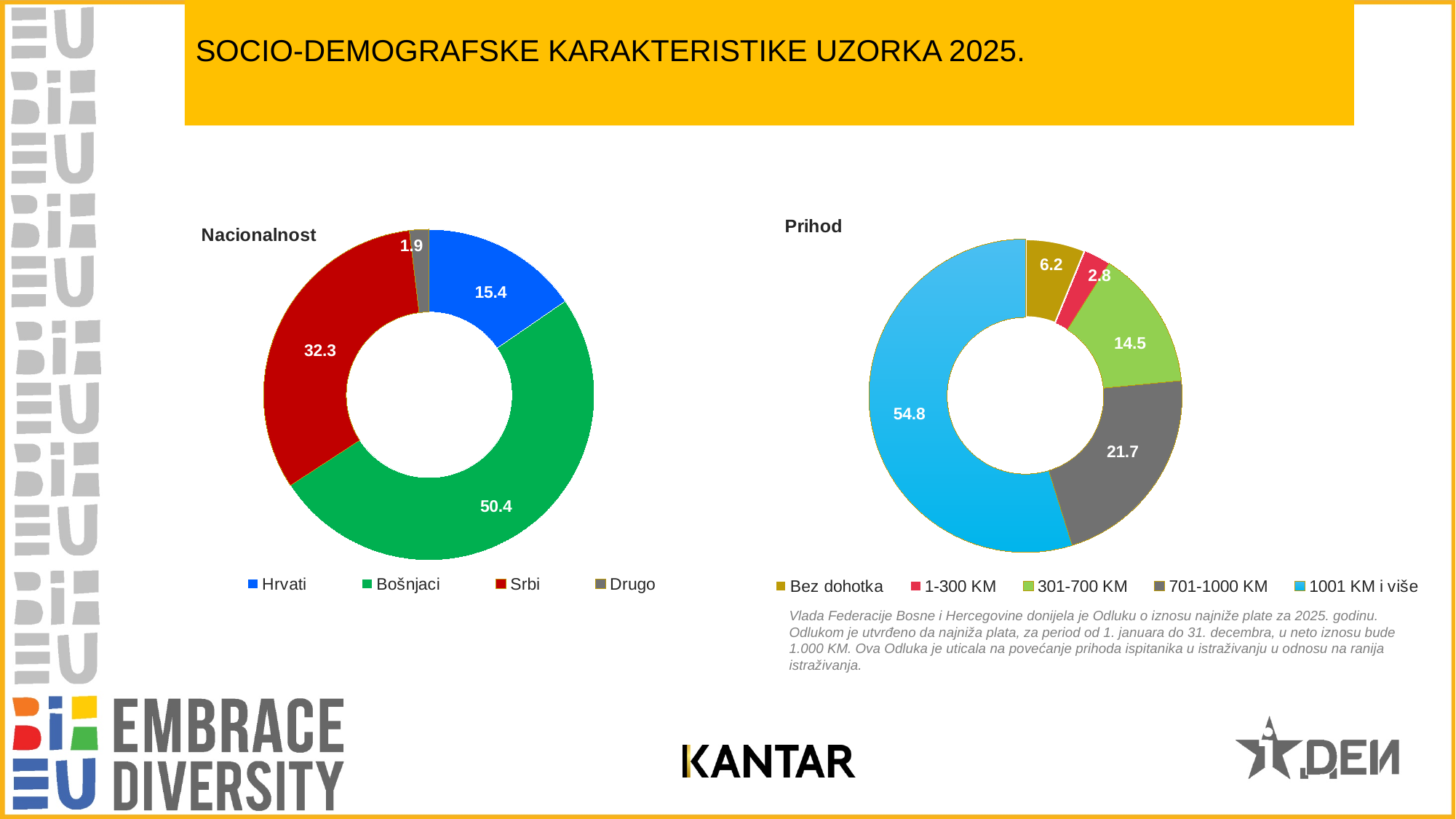
In the Prihod chart, what is the value for 701-1000 KM? 21.7 In the Nacionalnost chart, which category has the smallest share? Drugo In the Prihod chart, which is larger, the value for 301-700 KM or the value for 701-1000 KM? 701-1000 KM In the Nacionalnost chart, what is the difference between the values for Srbi and Hrvati? 16.9 In the Nacionalnost chart, what is the value for Bošnjaci? 50.4 In the Prihod chart, how many categories does the legend list? 5 In the Prihod chart, which category has the largest share? 1001 KM i više In the Prihod chart, what is the value for Bez dohotka? 6.2 In the Nacionalnost chart, how many categories are shown? 4 What type of chart is the Prihod chart? Doughnut chart In the Prihod chart, which category has the smallest share? 1-300 KM In the Nacionalnost chart, what is the value for Srbi? 32.3